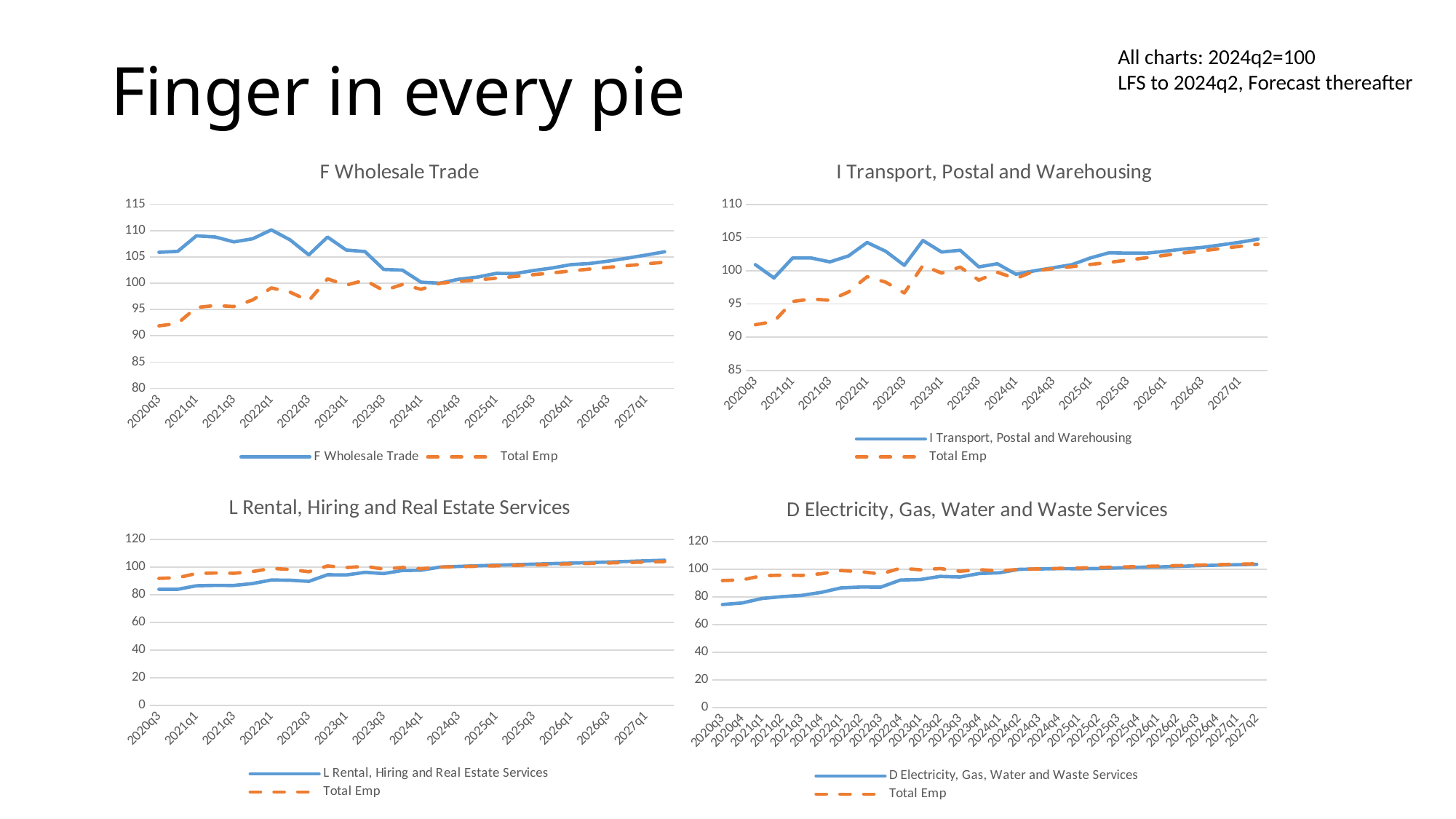
In the 'I Transport, Postal and Warehousing' chart, is the value of Total Emp at 2020q3 greater or less than 95? less In the 'D Electricity, Gas, Water and Waste Services' chart, does the D Electricity, Gas, Water and Waste Services series rise or fall overall from 2020q3 to 2027q2? rise In the 'F Wholesale Trade' chart, is the value of the F Wholesale Trade series at 2022q1 greater or less than 105? greater In the 'L Rental, Hiring and Real Estate Services' chart, does the Total Emp series rise or fall overall from 2020q3 to 2027q1? rise What is the title of the bottom-left chart on the slide? L Rental, Hiring and Real Estate Services In the 'L Rental, Hiring and Real Estate Services' chart, at 2020q3 which series has the larger value, L Rental, Hiring and Real Estate Services or Total Emp? Total Emp In the 'I Transport, Postal and Warehousing' chart, is the value of the I Transport, Postal and Warehousing series at 2023q1 greater or less than 100? greater What kind of chart is the 'F Wholesale Trade' chart? line chart How many series does the legend of the 'I Transport, Postal and Warehousing' chart list? 2 In the 'F Wholesale Trade' chart, at 2020q3 which series has the larger value, F Wholesale Trade or Total Emp? F Wholesale Trade